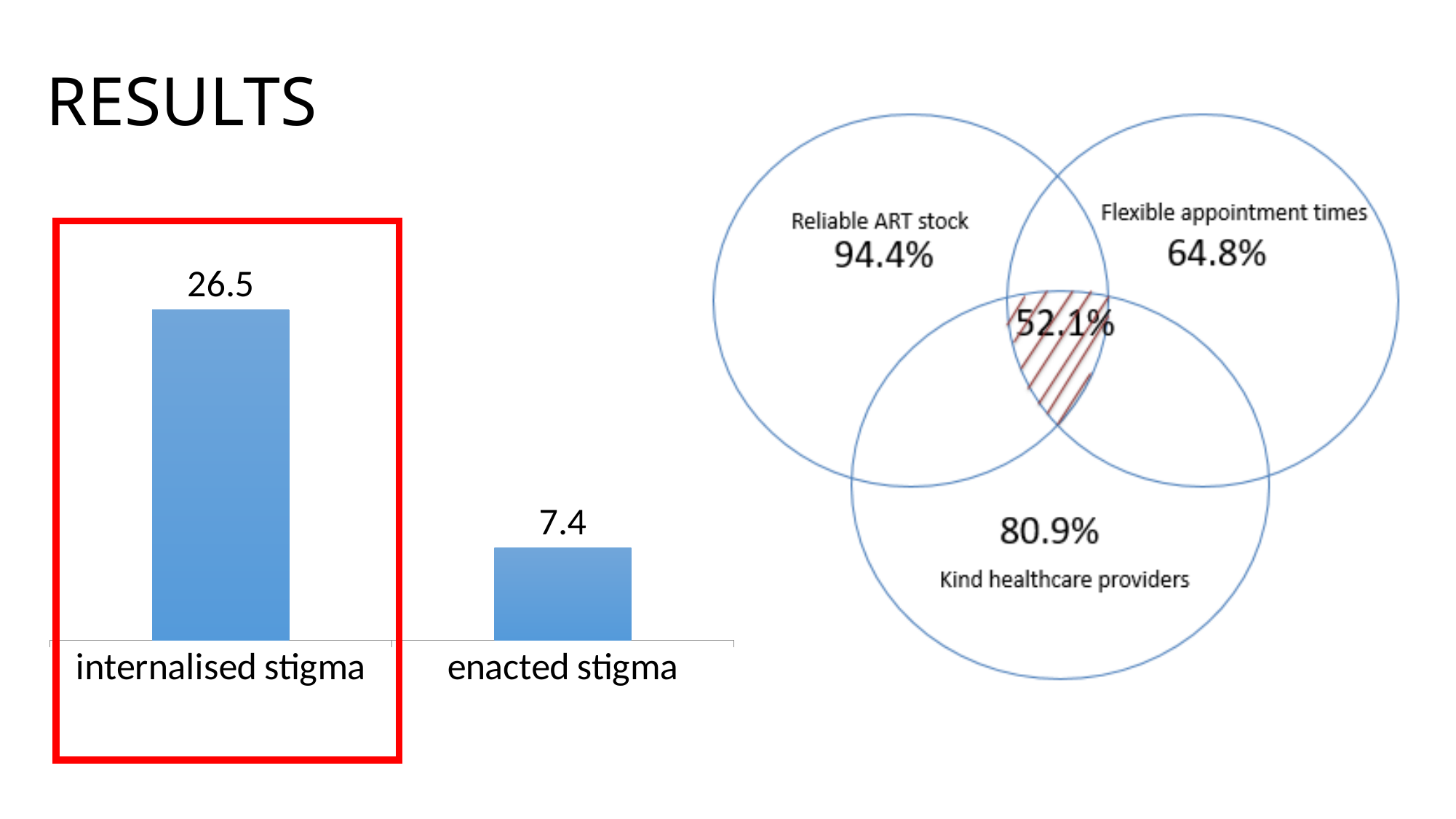
In the bar chart on the left, which is larger: internalised stigma or enacted stigma? internalised stigma In the Venn diagram on the right, what percentage is shown for Reliable ART stock? 94.4% In the Venn diagram on the right, what percentage is shown for Flexible appointment times? 64.8% In the bar chart on the left, what is the value for internalised stigma? 26.5 In the Venn diagram on the right, what percentage is shown in the hatched overlap of all three circles? 52.1% In the bar chart on the left, which category has the lowest value? enacted stigma In the bar chart on the left, what is the difference between the values for internalised stigma and enacted stigma? 19.1 In the bar chart on the left, which category has the highest value? internalised stigma How many categories are shown in the bar chart on the left? 2 In the bar chart on the left, what is the value for enacted stigma? 7.4 In the bar chart on the left, which category is outlined with a red box? internalised stigma What kind of chart is shown on the left of the slide? bar chart